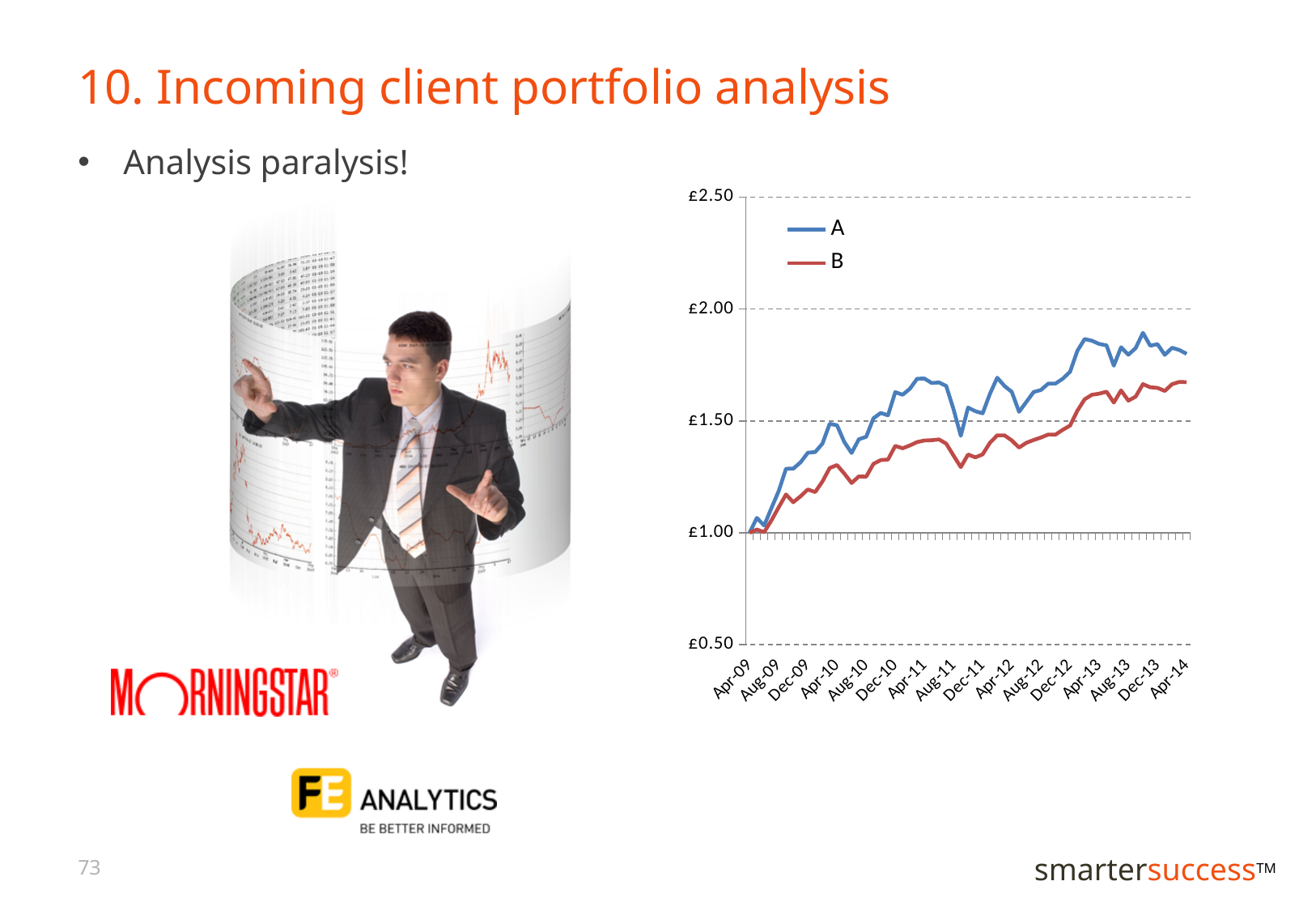
What are the names of the two series in the chart legend? A and B Is the value for series B at Apr-14 greater or less than £1.50? greater What kind of chart is shown on the slide? line chart How many series does the chart legend list? 2 Which series reaches the highest value anywhere on the chart? A Is the value for series A at Apr-13 greater or less than £2.00? less Which series, A or B, has the higher value at Apr-14? A Do the values for series A generally rise or fall from Apr-09 to Apr-14? rise Is the value for series A at Apr-14 greater or less than £1.50? greater What colour is the line for series A? blue Do the values for series B generally rise or fall from Apr-09 to Apr-14? rise